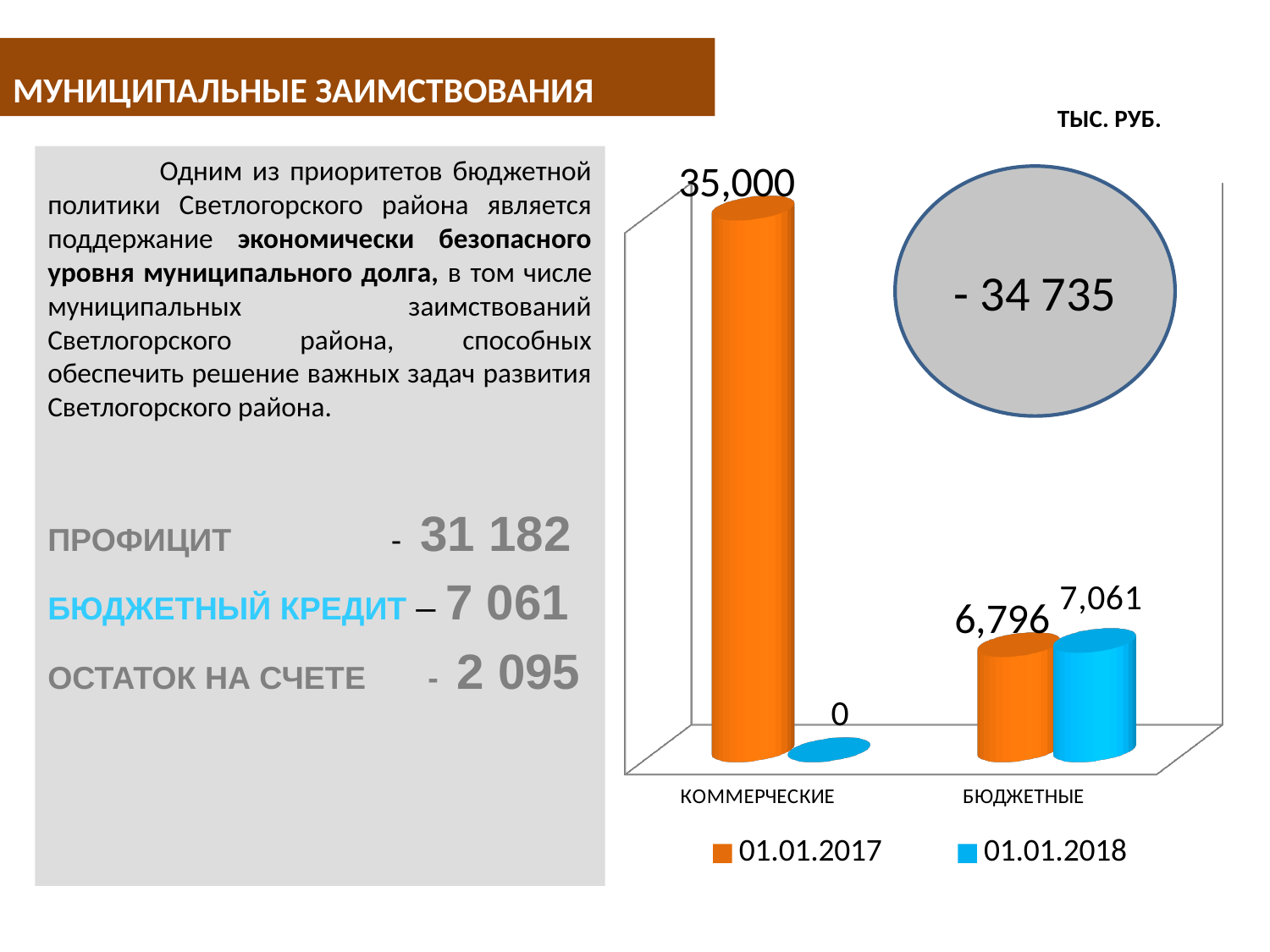
What is the value for БЮДЖЕТНЫЕ in the 01.01.2018 series? 7,061 What is the value for КОММЕРЧЕСКИЕ in the 01.01.2017 series? 35,000 What kind of chart is shown on the slide? Bar chart What is the difference between the 01.01.2017 and 01.01.2018 values for КОММЕРЧЕСКИЕ? 35,000 What is the value for БЮДЖЕТНЫЕ in the 01.01.2017 series? 6,796 For БЮДЖЕТНЫЕ, which series has the larger value, 01.01.2017 or 01.01.2018? 01.01.2018 Which category has the highest value in the 01.01.2017 series? КОММЕРЧЕСКИЕ How many series does the chart legend list? 2 What is the value for КОММЕРЧЕСКИЕ in the 01.01.2018 series? 0 Which category has the lowest value in the 01.01.2018 series? КОММЕРЧЕСКИЕ How many categories are shown on the x axis of the chart? 2 What is the difference between the 01.01.2018 and 01.01.2017 values for БЮДЖЕТНЫЕ? 265